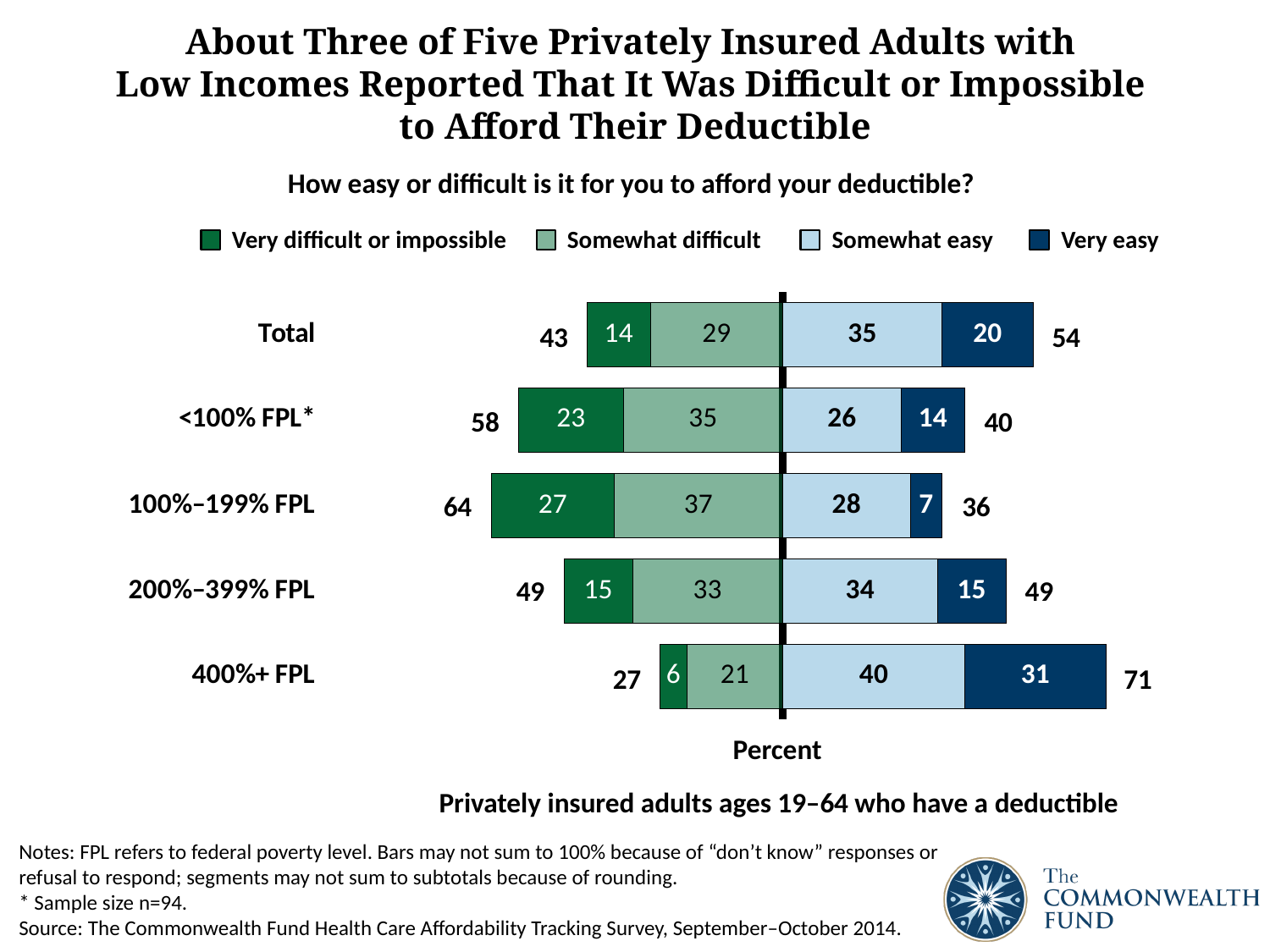
Which group has a larger 'Somewhat easy' value, 200%–399% FPL or 100%–199% FPL? 200%–399% FPL How many response categories does the legend list? 4 How many income categories (including Total) are shown in the chart? 5 What is the difference between the 'Somewhat difficult' values for <100% FPL and 400%+ FPL? 14 What percentage of adults in the 400%+ FPL group said it was very easy to afford their deductible? 31 What is the 'Somewhat easy' value for the Total bar? 35 What percentage of adults in the 100%–199% FPL group said it was very difficult or impossible to afford their deductible? 27 What is the combined percentage of 'Very difficult or impossible' and 'Somewhat difficult' responses for the 100%–199% FPL group, as printed on the slide? 64 Which income group has the highest 'Very easy' value? 400%+ FPL Which income group has the lowest 'Very difficult or impossible' value? 400%+ FPL Which income group has the highest 'Very difficult or impossible' value? 100%–199% FPL What kind of chart is shown on the slide? Stacked bar chart